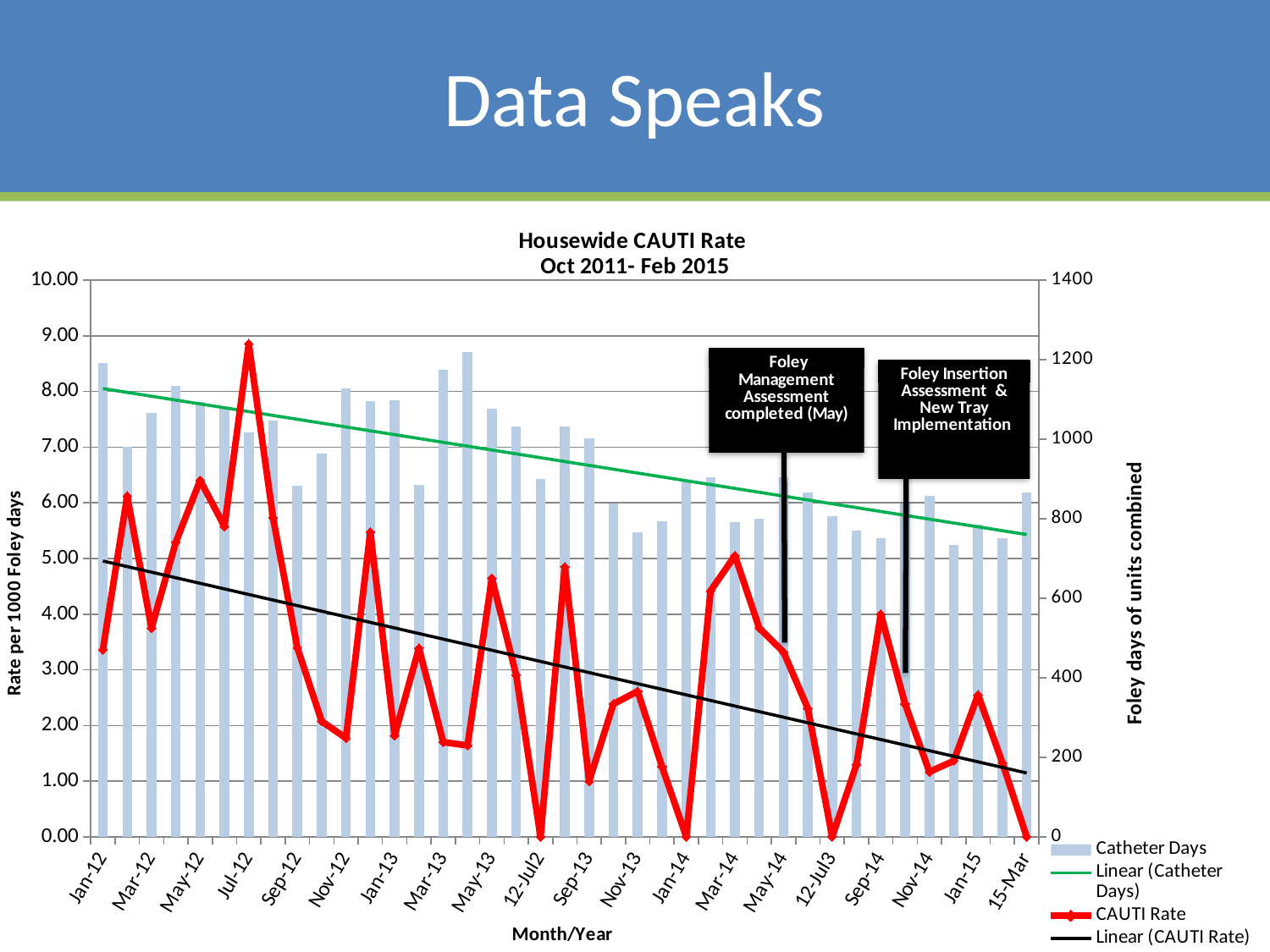
What is the label of the left vertical axis? Rate per 1000 Foley days Is the CAUTI Rate for Jan-12 greater or less than 4.00? less What kind of chart is this? Combined bar and line chart Does the Linear (Catheter Days) trendline rise or fall across the chart? fall How many series does the legend list? 4 In which month does the CAUTI Rate line reach its highest value? Jul-12 What is the title of the chart? Housewide CAUTI Rate Oct 2011- Feb 2015 Is the Catheter Days value for Jan-12 greater or less than 1000? greater Does the Linear (CAUTI Rate) trendline rise or fall from left to right? fall Is the CAUTI Rate for Jul-12 greater or less than 8.00? greater Which month has the higher CAUTI Rate, Jan-12 or Jul-12? Jul-12